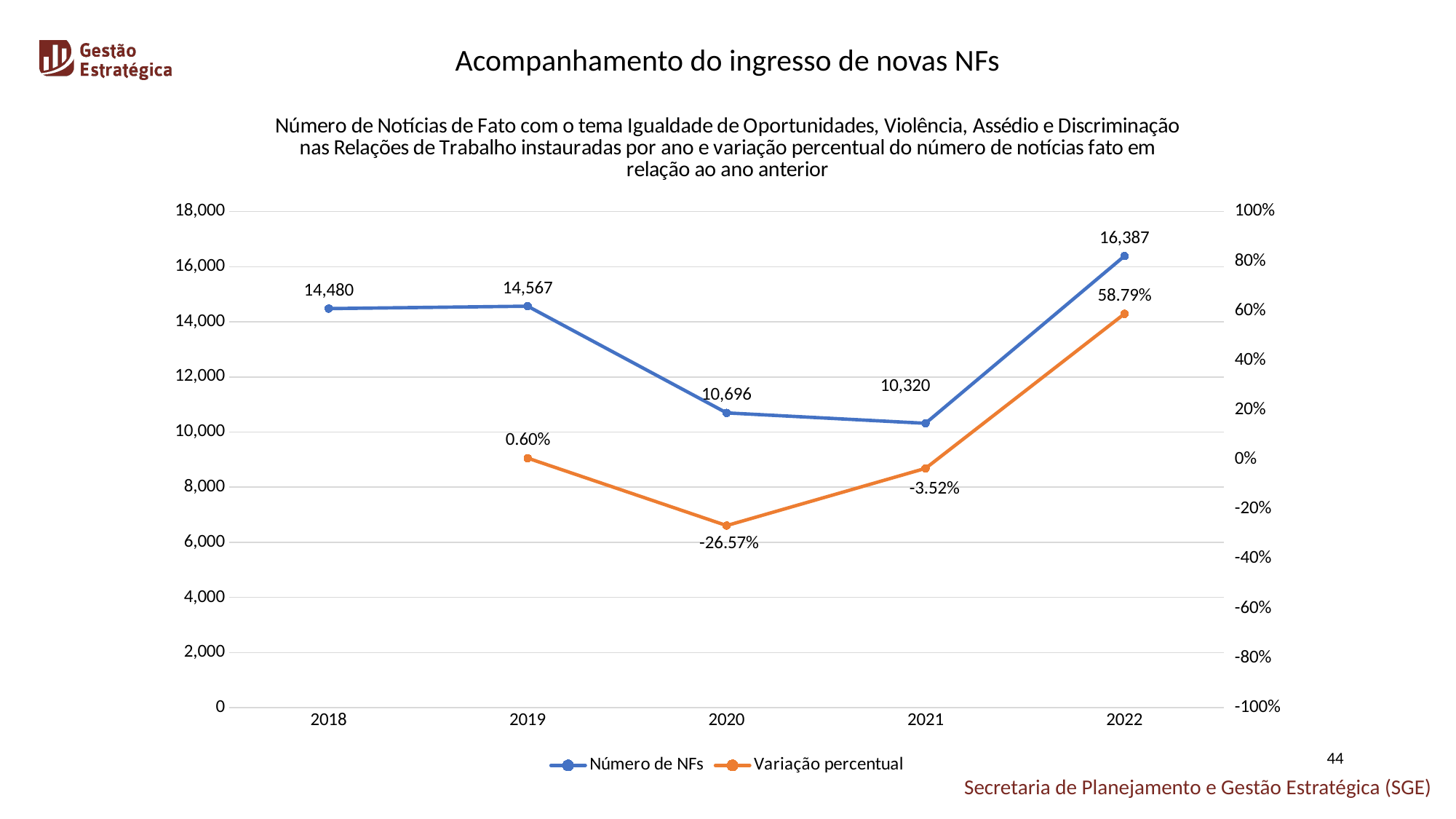
How many years are shown on the x axis? 5 Which year has the highest Número de NFs? 2022 What kind of chart is shown on the slide? Line chart How many series does the legend list? 2 What is the difference in Número de NFs between 2022 and 2021? 6,067 Which is larger, the Número de NFs in 2019 or in 2018? 2019 What is the value of Número de NFs in 2018? 14,480 Which year has the lowest Número de NFs? 2021 What is the Variação percentual for 2020? -26.57% What is the value of Número de NFs in 2022? 16,387 What is the Variação percentual for 2022? 58.79% Which year has the lowest Variação percentual? 2020